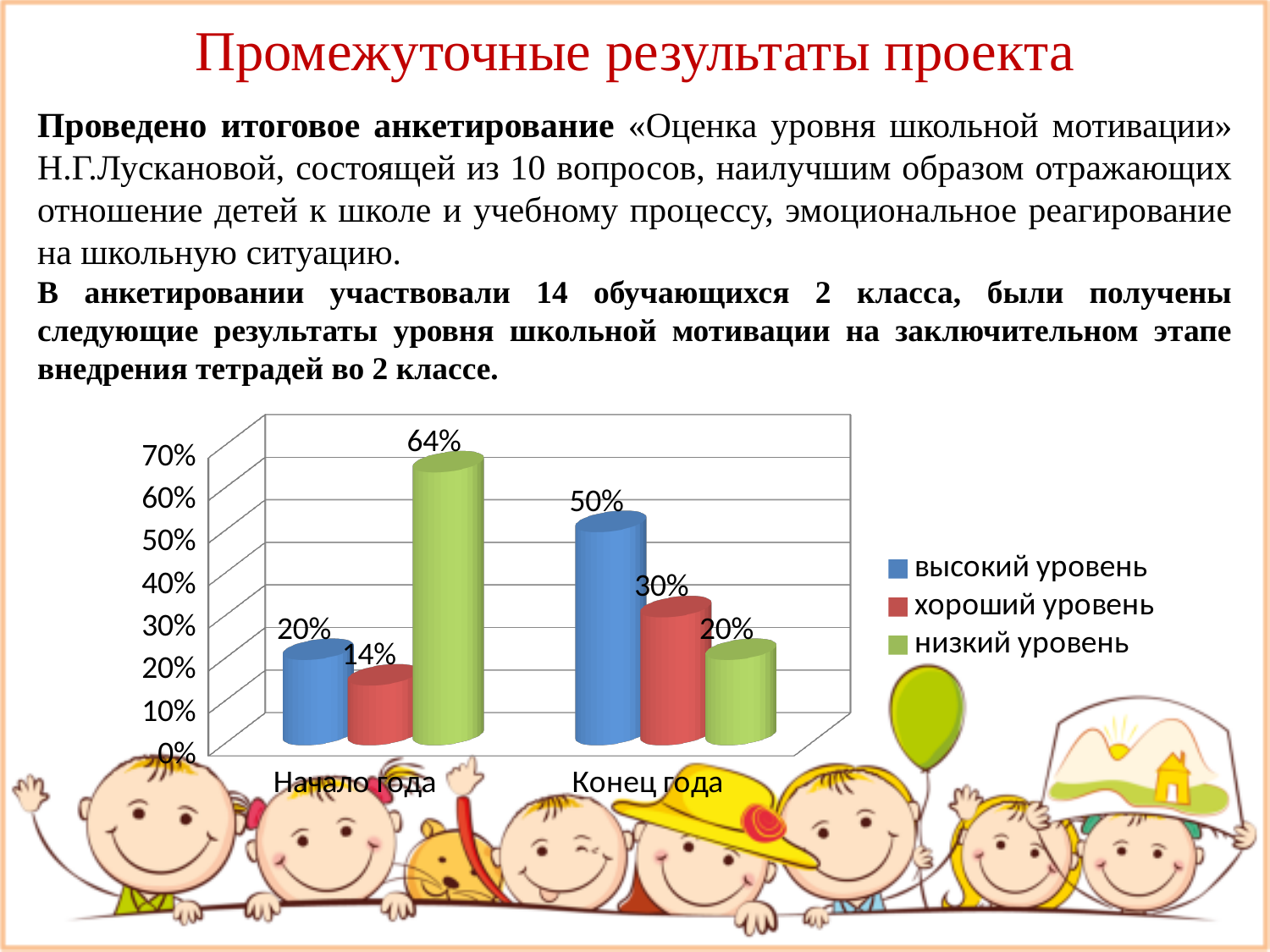
What is the value for 'высокий уровень' at 'Начало года'? 20% Which series has the lowest value at 'Конец года'? низкий уровень Which is larger: 'высокий уровень' at 'Конец года' or 'хороший уровень' at 'Конец года'? высокий уровень at Конец года What is the value for 'низкий уровень' at 'Начало года'? 64% What is the value for 'хороший уровень' at 'Конец года'? 30% What is the difference between 'низкий уровень' at 'Начало года' and at 'Конец года'? 44% Does the value for 'высокий уровень' rise or fall from 'Начало года' to 'Конец года'? rise How many categories are shown on the x axis? 2 How many series does the legend list? 3 Which series has the highest value at 'Начало года'? низкий уровень What is the value for 'высокий уровень' at 'Конец года'? 50% What kind of chart is shown on the slide? bar chart